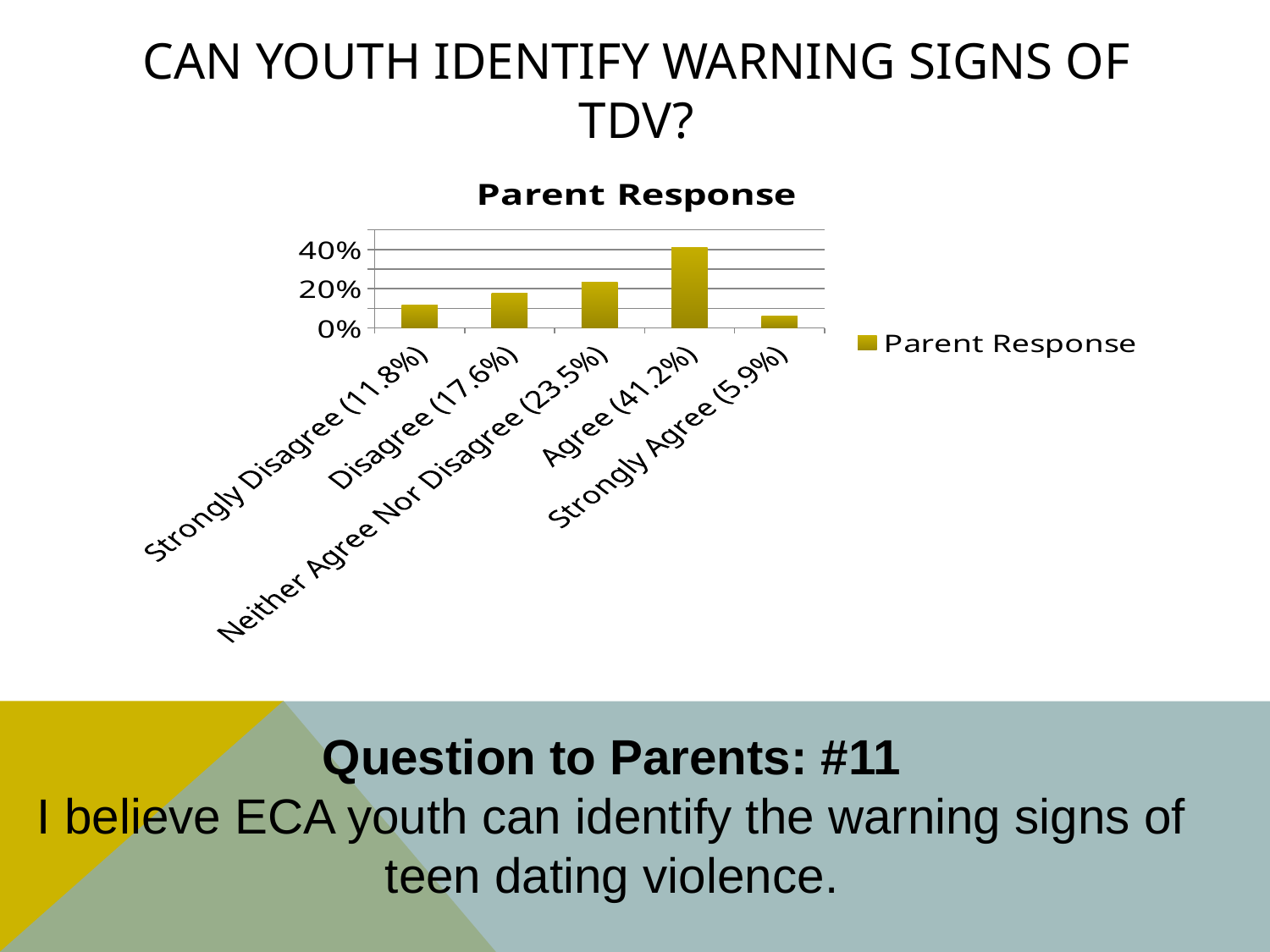
What is the value for Strongly Disagree in the Parent Response chart? 11.8% What is the value for Neither Agree Nor Disagree in the Parent Response chart? 23.5% What kind of chart is the Parent Response chart? Bar chart What is the difference between the values for Agree and Strongly Agree in the Parent Response chart? 35.3% How many categories are shown in the Parent Response chart? 5 How many series does the legend of the Parent Response chart list? 1 What is the value for Agree in the Parent Response chart? 41.2% Is the value for Agree greater or less than 40% in the Parent Response chart? greater What is the difference between the values for Disagree and Strongly Disagree in the Parent Response chart? 5.8% Which is larger in the Parent Response chart, Disagree or Neither Agree Nor Disagree? Neither Agree Nor Disagree Which category has the lowest value in the Parent Response chart? Strongly Agree Which category has the highest value in the Parent Response chart? Agree